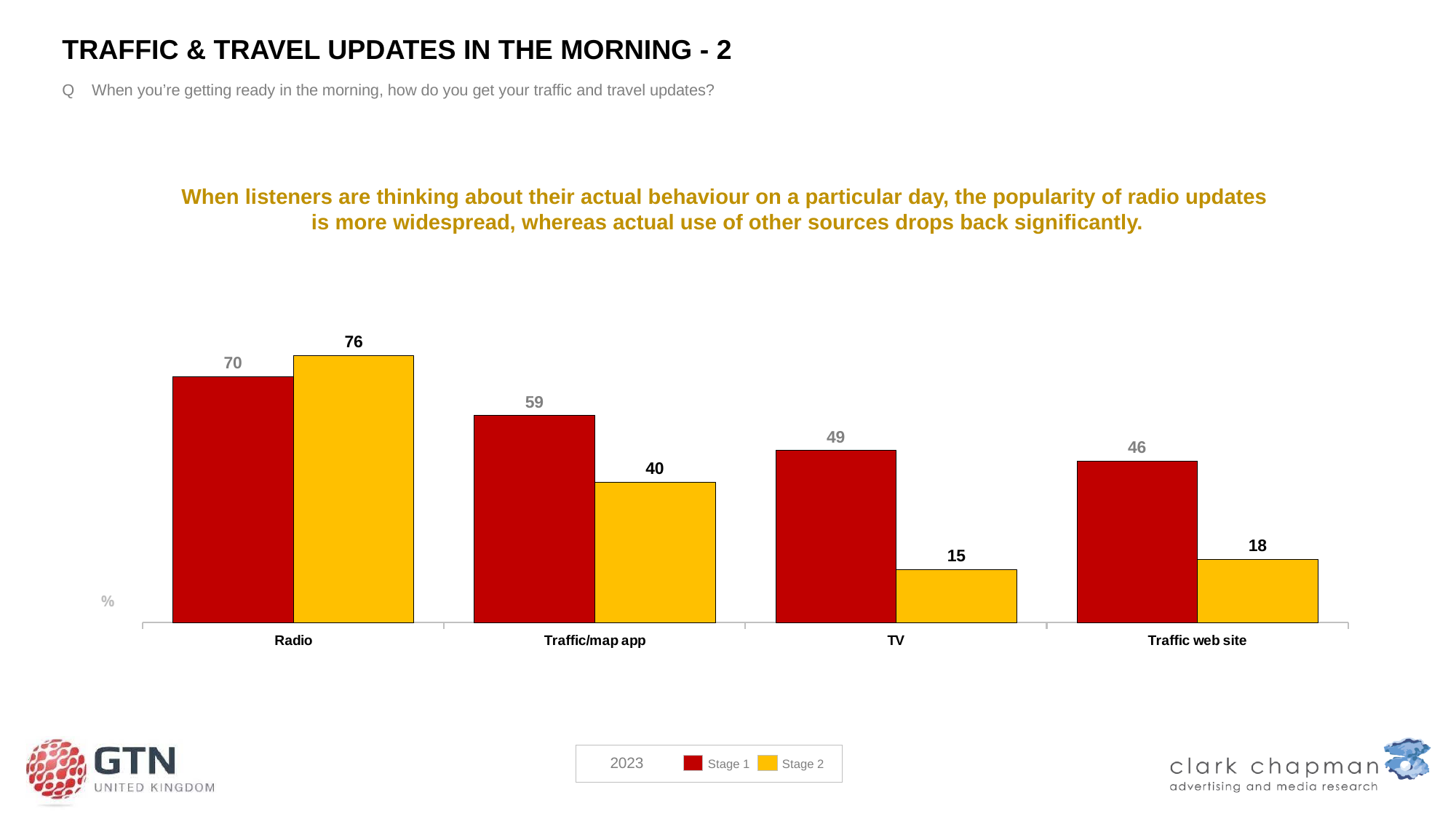
What is the Stage 2 value for TV? 15 What is the Stage 2 value for Traffic/map app? 40 Which category has the highest Stage 2 value? Radio How many categories are shown on the x axis? 4 Which category has the lowest Stage 2 value? TV What kind of chart is shown on the slide? Bar chart Which is larger for Radio, the Stage 1 value or the Stage 2 value? Stage 2 What is the Stage 1 value for Traffic web site? 46 How many series does the legend list? 2 Which category has the lowest Stage 1 value? Traffic web site What is the Stage 1 value for Radio? 70 What is the difference between the Stage 1 and Stage 2 values for TV? 34